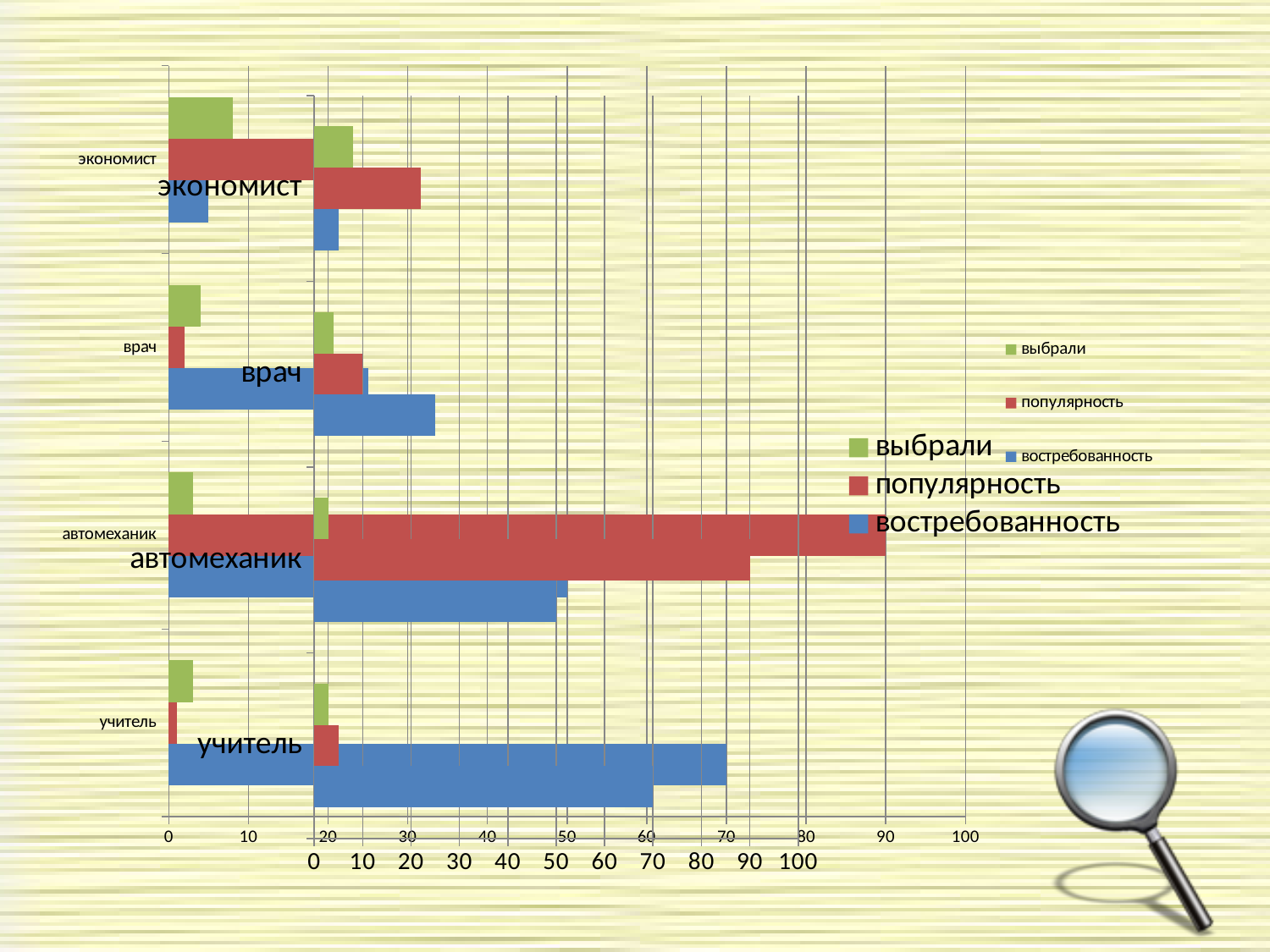
In the front chart with the large labels, is the популярность value for автомеханик greater or less than 80? greater What kind of chart is the large front chart with the big category labels? bar chart In the front chart with the large labels, is the востребованность value for учитель greater or less than 60? greater In the front chart with the large labels, is the востребованность value for автомеханик greater or less than 40? greater In the front chart with the large labels, which category has the highest востребованность value? учитель In the front chart with the large labels, which category has the highest популярность value? автомеханик How many categories does the front chart with the large labels show? 4 How many series does the legend of the front chart list? 3 In the front chart with the large labels, which category has the lowest востребованность value? экономист In the front chart, which colour represents the востребованность series? blue In the front chart with the large labels, which is larger for учитель: популярность or востребованность? востребованность